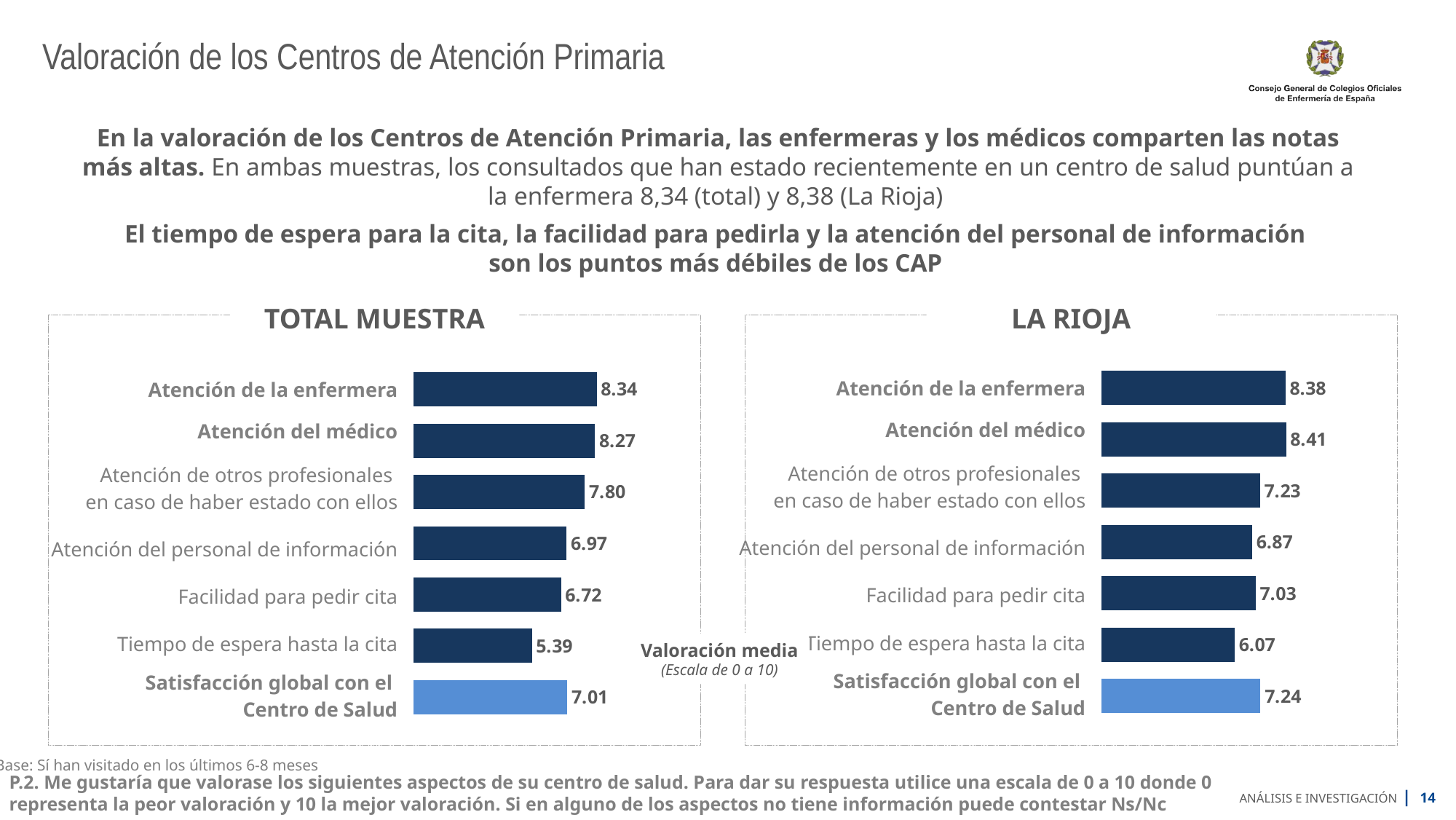
In the LA RIOJA chart, what is the value for Atención del médico? 8.41 In the LA RIOJA chart, what is the value for Satisfacción global con el Centro de Salud? 7.24 How many categories are shown in the LA RIOJA chart? 7 In the TOTAL MUESTRA chart, which category is shown with a lighter blue bar than the others? Satisfacción global con el Centro de Salud In the TOTAL MUESTRA chart, which category has the lowest value? Tiempo de espera hasta la cita In the LA RIOJA chart, which category has the highest value? Atención del médico Which is larger: Facilidad para pedir cita in the TOTAL MUESTRA chart or in the LA RIOJA chart? LA RIOJA In the TOTAL MUESTRA chart, what is the difference between Atención de la enfermera and Tiempo de espera hasta la cita? 2.95 In the TOTAL MUESTRA chart, what is the difference between Atención de la enfermera and Atención del médico? 0.07 In the TOTAL MUESTRA chart, what is the value for Tiempo de espera hasta la cita? 5.39 What type of chart is the TOTAL MUESTRA chart? Bar chart In the TOTAL MUESTRA chart, what is the value for Atención de la enfermera? 8.34